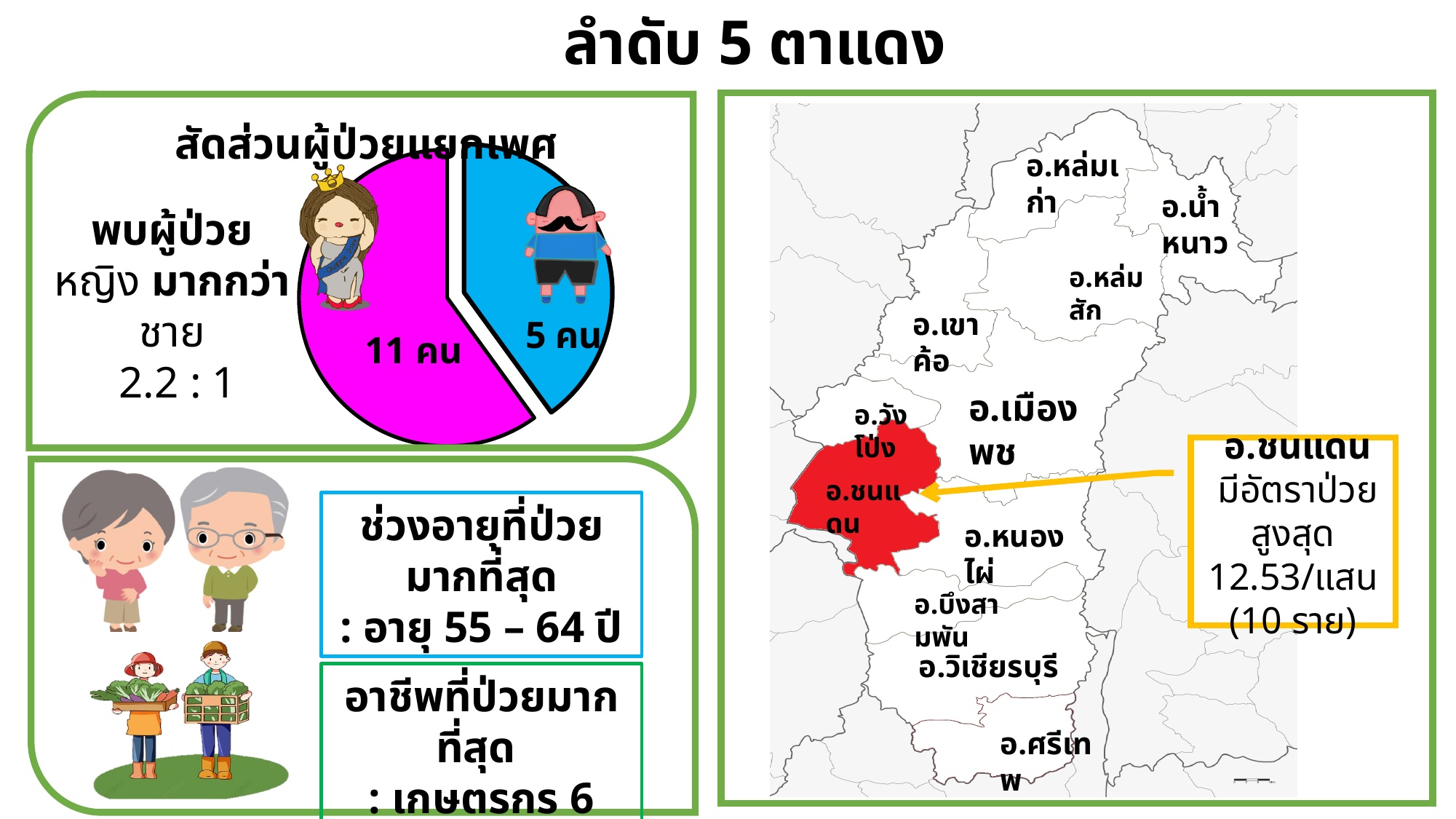
In the pie chart สัดส่วนผู้ป่วยแยกเพศ, which slice is larger, the female (หญิง) slice or the male (ชาย) slice? หญิง (female) According to the text next to the pie chart, what is the ratio of female to male patients? 2.2 : 1 What is the total number of patients represented in the pie chart สัดส่วนผู้ป่วยแยกเพศ? 16 คน In the pie chart สัดส่วนผู้ป่วยแยกเพศ, how many patients are in the magenta (female, หญิง) slice? 11 คน In the pie chart สัดส่วนผู้ป่วยแยกเพศ, which group has the smallest number of patients? ชาย (male), 5 คน How many slices does the pie chart สัดส่วนผู้ป่วยแยกเพศ have? 2 What is the title of the pie chart in the top-left panel? สัดส่วนผู้ป่วยแยกเพศ In the pie chart สัดส่วนผู้ป่วยแยกเพศ, how many more female patients are there than male patients? 6 คน What share of the patients in the pie chart สัดส่วนผู้ป่วยแยกเพศ are male (5 of 16)? 31.25% In the pie chart สัดส่วนผู้ป่วยแยกเพศ, how many patients are in the blue (male, ชาย) slice? 5 คน In the pie chart สัดส่วนผู้ป่วยแยกเพศ, what colour is the slice representing female patients (11 คน)? magenta (pink) What kind of chart is shown in the top-left panel titled สัดส่วนผู้ป่วยแยกเพศ? pie chart